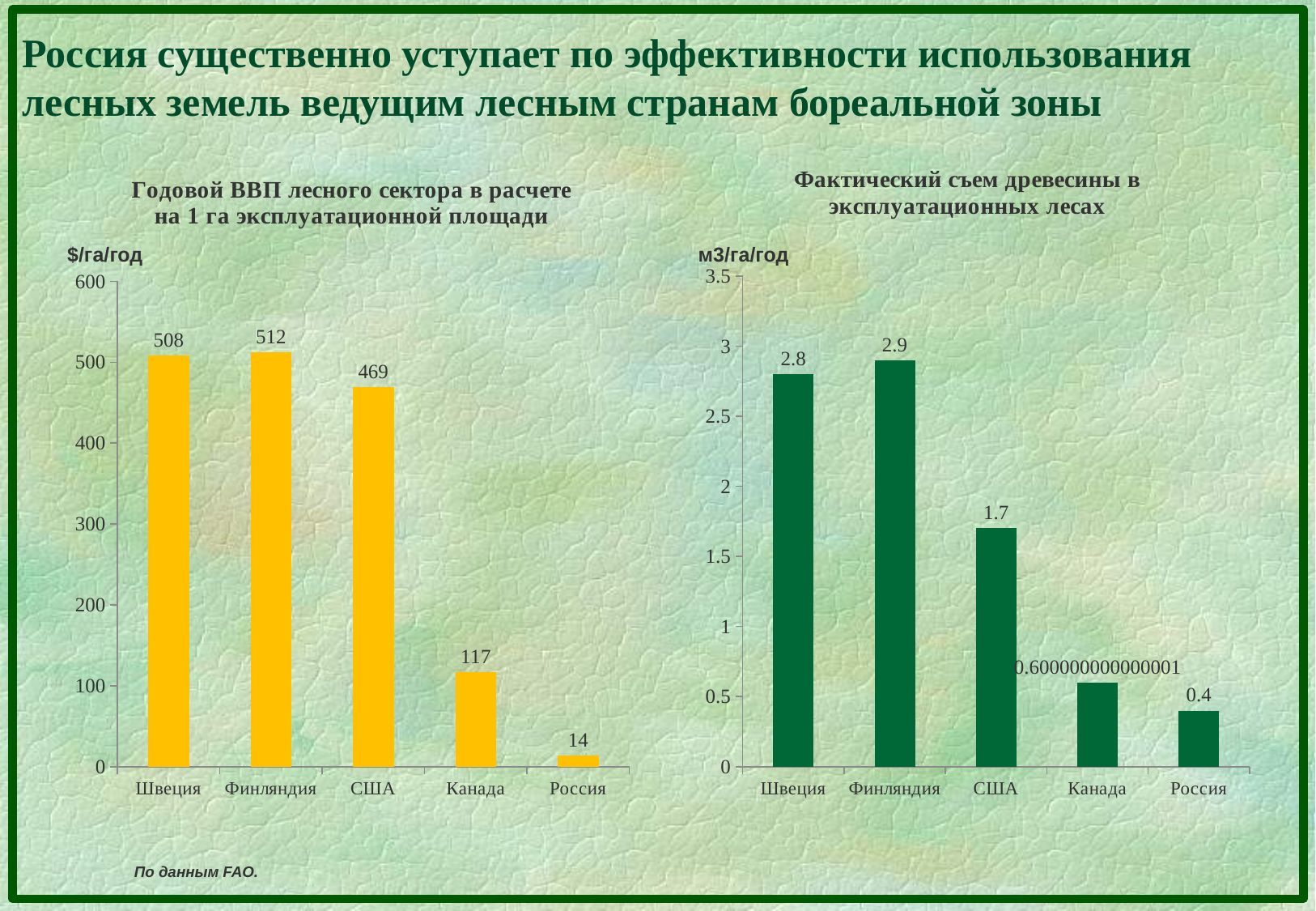
In the left chart (Годовой ВВП лесного сектора), what is the difference between the values for США and Канада? 352 In the left chart (Годовой ВВП лесного сектора), which is larger, the value for Швеция or the value for США? Швеция What type of chart is the right chart (Фактический съем древесины)? bar chart In the right chart (Фактический съем древесины), what is the value for Россия? 0.4 In the right chart (Фактический съем древесины), which country has the highest value? Финляндия In the right chart (Фактический съем древесины), is the value for США greater or less than 1.5? greater How many countries are shown in the left chart (Годовой ВВП лесного сектора)? 5 In the left chart (Годовой ВВП лесного сектора), what is the value for Россия? 14 In the right chart (Фактический съем древесины), what is the difference between the values for Швеция and США? 1.1 In the left chart (Годовой ВВП лесного сектора в расчете на 1 га эксплуатационной площади), what is the value for Финляндия? 512 In the right chart (Фактический съем древесины в эксплуатационных лесах), what is the value for Финляндия? 2.9 In the left chart (Годовой ВВП лесного сектора), which country has the lowest value? Россия